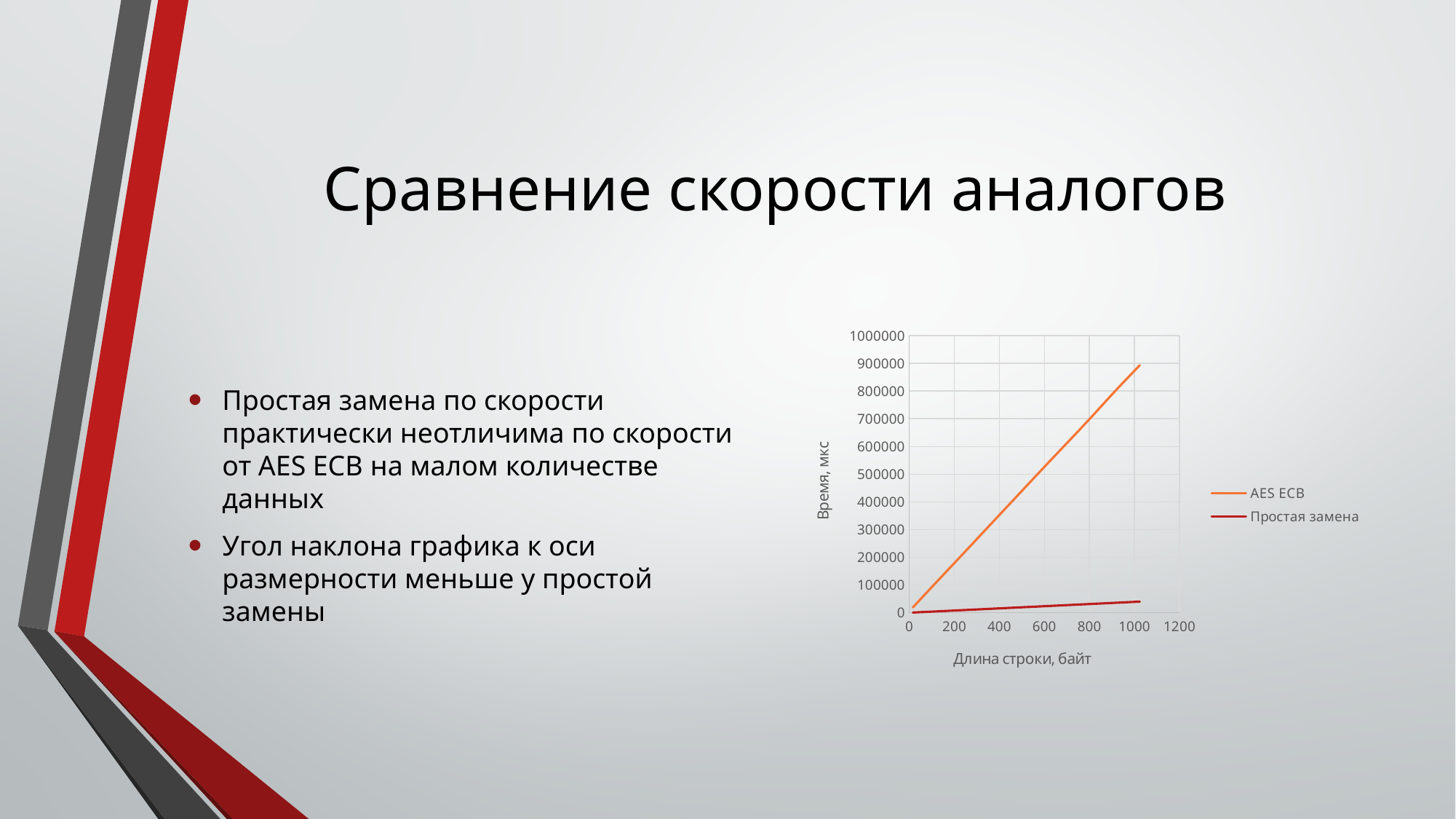
Does the Простая замена line rise or fall as the string length increases along the x axis? rise Is the highest value of the AES ECB series greater or less than 1000000? less Which series are listed in the chart legend? AES ECB and Простая замена Does the AES ECB line rise or fall as the string length increases along the x axis? rise Is the highest value of the Простая замена series greater or less than 100000? less Is the value of the AES ECB series at a string length of 600 bytes greater or less than 400000? greater What is the title of the vertical axis of the chart? Время, мкс Which series has the lower time values across the chart? Простая замена What kind of chart is shown on the slide? line chart How many series does the chart legend list? 2 Which series reaches the higher time value at the right end of the chart, AES ECB or Простая замена? AES ECB